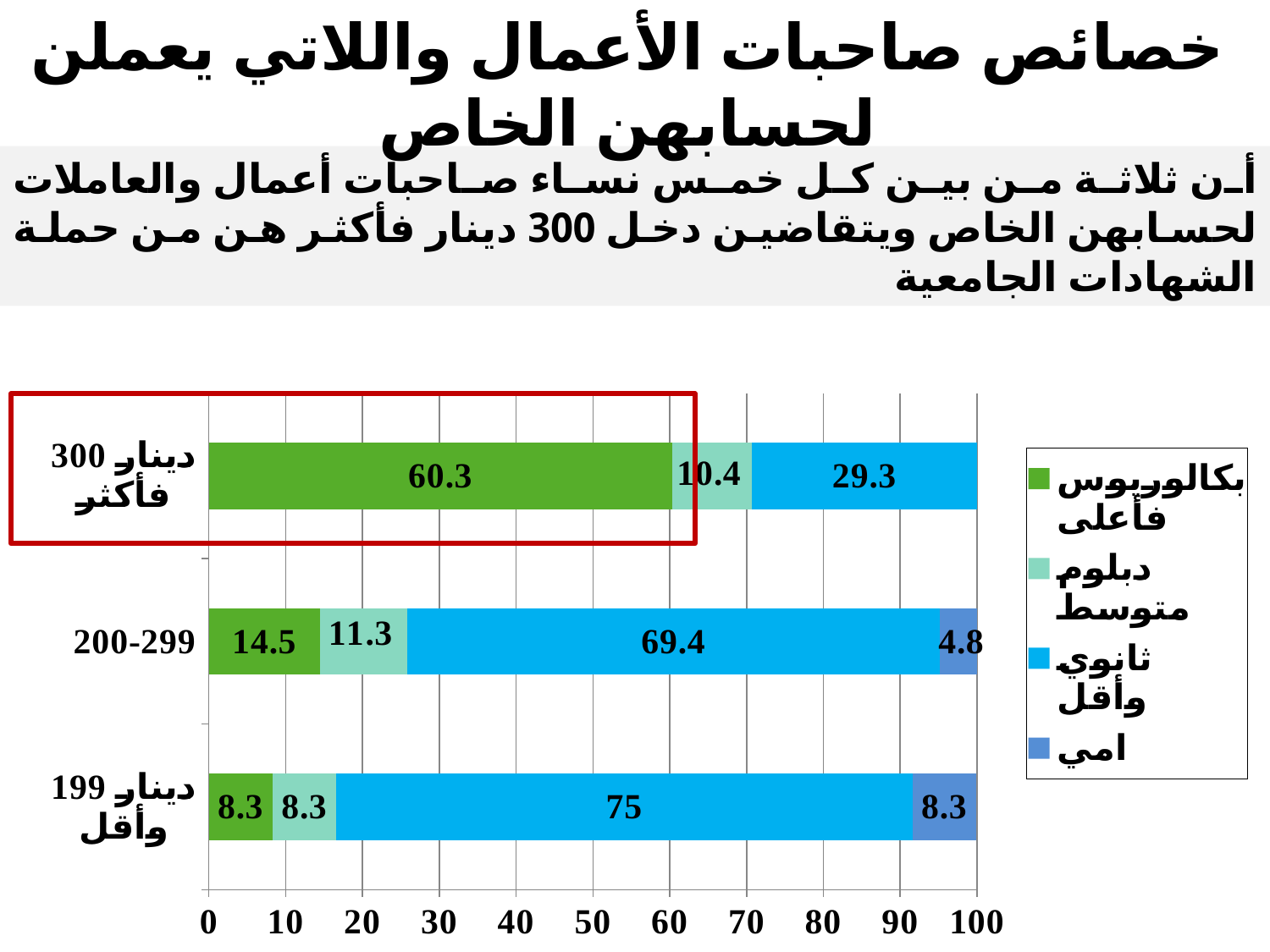
What is the difference between the ثانوي وأقل values for 199 دينار وأقل and 200-299? 5.6 What is the value for ثانوي وأقل in the 200-299 category? 69.4 Which is larger: the امي value for 200-299 or for 199 دينار وأقل? 199 دينار وأقل What is the value for دبلوم متوسط in the 300 دينار فأكثر category? 10.4 What kind of chart is shown on the slide? stacked bar chart How many income categories are shown on the chart? 3 How many series does the legend list? 4 What is the value for امي in the 199 دينار وأقل category? 8.3 Which series is shown in green in the legend? بكالوريوس فأعلى What is the value for بكالوريوس فأعلى in the 300 دينار فأكثر category? 60.3 Which income category has the highest value for بكالوريوس فأعلى? 300 دينار فأكثر Which income category has the lowest value for ثانوي وأقل? 300 دينار فأكثر